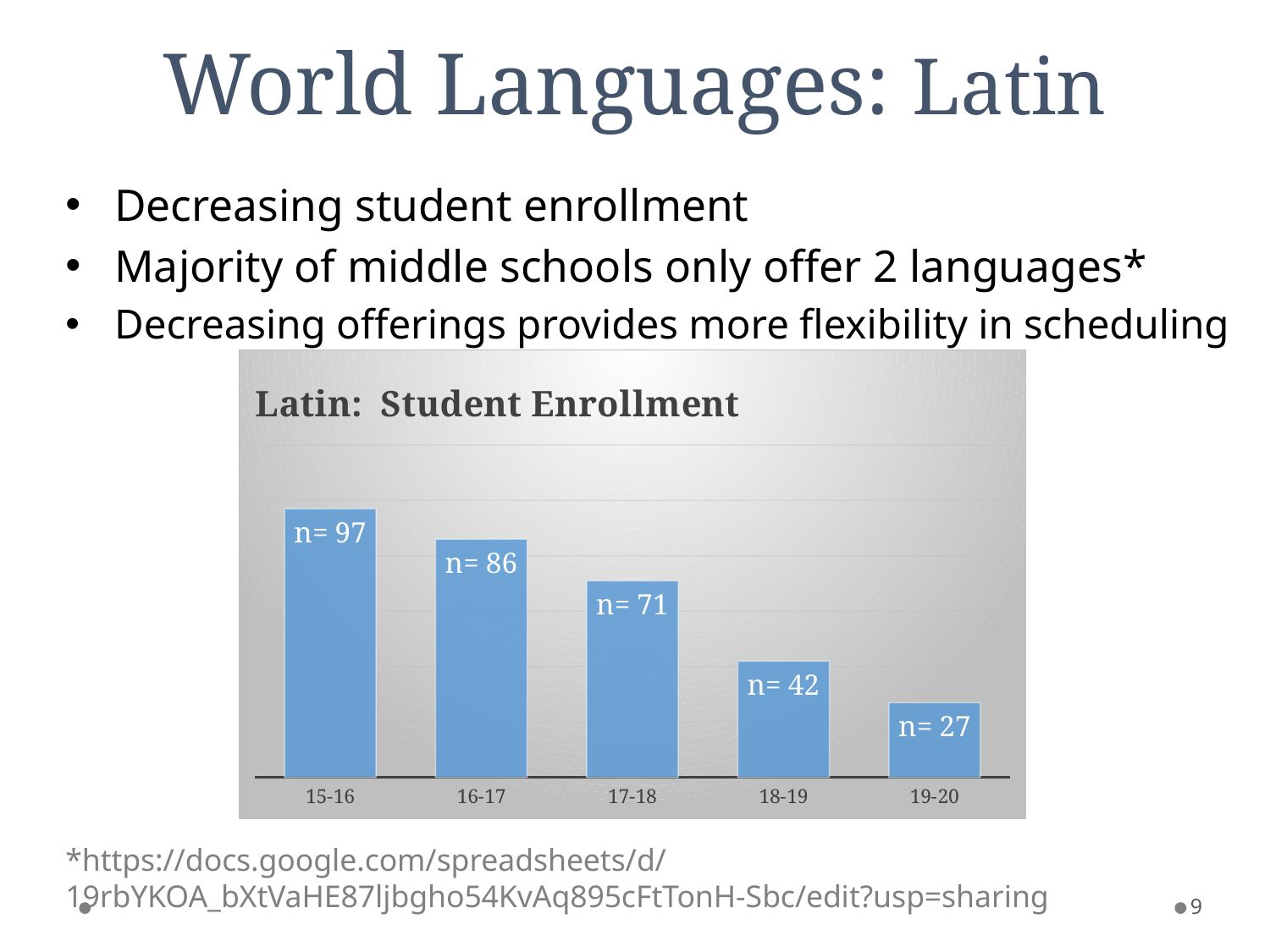
What is the student enrollment for 19-20? n= 27 What is the difference in enrollment between 17-18 and 18-19? 29 What is the difference in enrollment between 15-16 and 19-20? 70 What is the student enrollment for 17-18? n= 71 What kind of chart is shown on the slide? Bar chart How many school years are shown on the chart? 5 What is the student enrollment for 15-16? n= 97 Which year has higher enrollment, 16-17 or 18-19? 16-17 What is the title of the chart? Latin: Student Enrollment Which year has the highest Latin student enrollment? 15-16 Does Latin student enrollment rise or fall from 15-16 to 19-20? Fall Which year has the lowest Latin student enrollment? 19-20